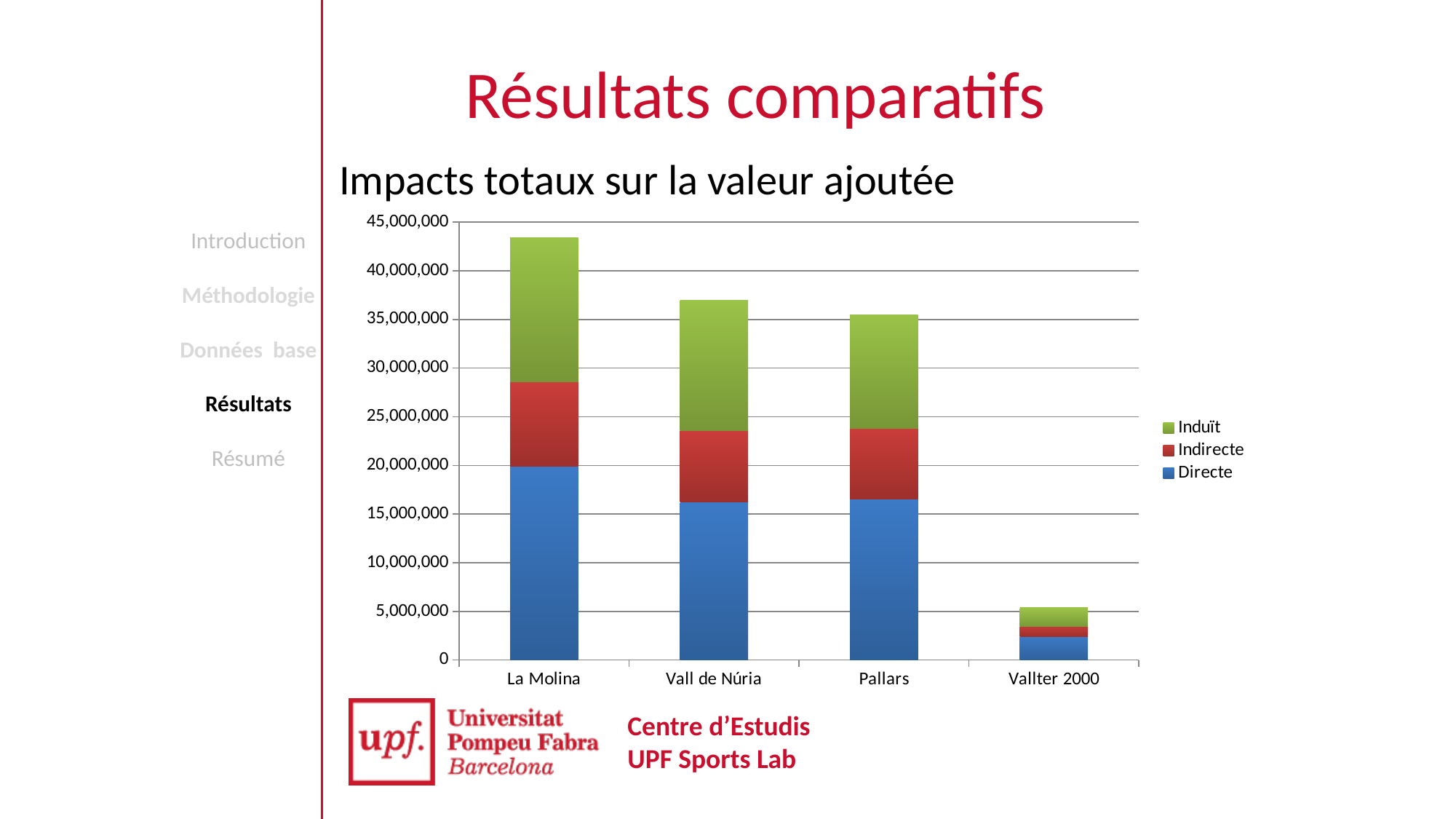
Which category has the lowest total stacked bar? Vallter 2000 Which has a larger total bar, La Molina or Vall de Núria? La Molina Is the total value for Pallars greater or less than 30,000,000? greater How many categories (ski resorts) are shown on the x axis? 4 What kind of chart is shown on the slide? Stacked bar chart Which category has the highest total stacked bar? La Molina What are the three series listed in the legend? Induït, Indirecte, Directe Which has a larger total bar, Pallars or Vallter 2000? Pallars What is the title of the chart? Impacts totaux sur la valeur ajoutée Is the total value for Vallter 2000 greater or less than 10,000,000? less How many series does the legend list? 3 Is the total value for La Molina greater or less than 40,000,000? greater